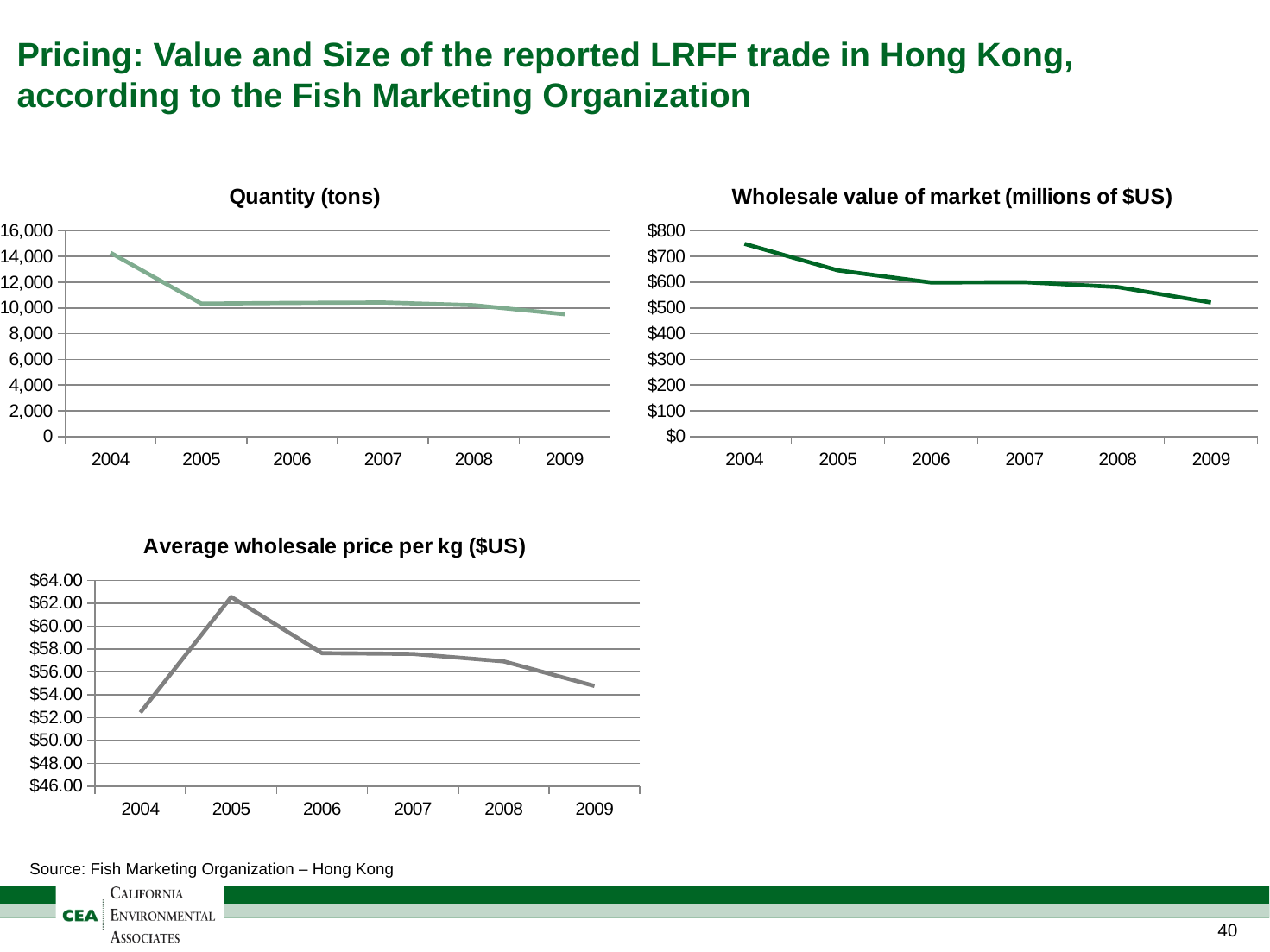
In the 'Quantity (tons)' chart, which year has the highest quantity? 2004 In the 'Wholesale value of market (millions of $US)' chart, do values generally rise or fall from 2004 to 2009? fall In the 'Average wholesale price per kg ($US)' chart, which year has the highest price? 2005 What kind of chart is the 'Quantity (tons)' chart? line chart In the 'Wholesale value of market (millions of $US)' chart, which year has the lowest value? 2009 In the 'Wholesale value of market (millions of $US)' chart, which is larger, the value for 2005 or the value for 2009? 2005 In the 'Quantity (tons)' chart, is the value for 2009 greater or less than 10,000? less In the 'Average wholesale price per kg ($US)' chart, which year has the lowest price? 2004 In the 'Average wholesale price per kg ($US)' chart, is the value for 2005 greater or less than $60.00? greater In the 'Quantity (tons)' chart, is the value for 2004 greater or less than 12,000? greater How many years are plotted in the 'Quantity (tons)' chart? 6